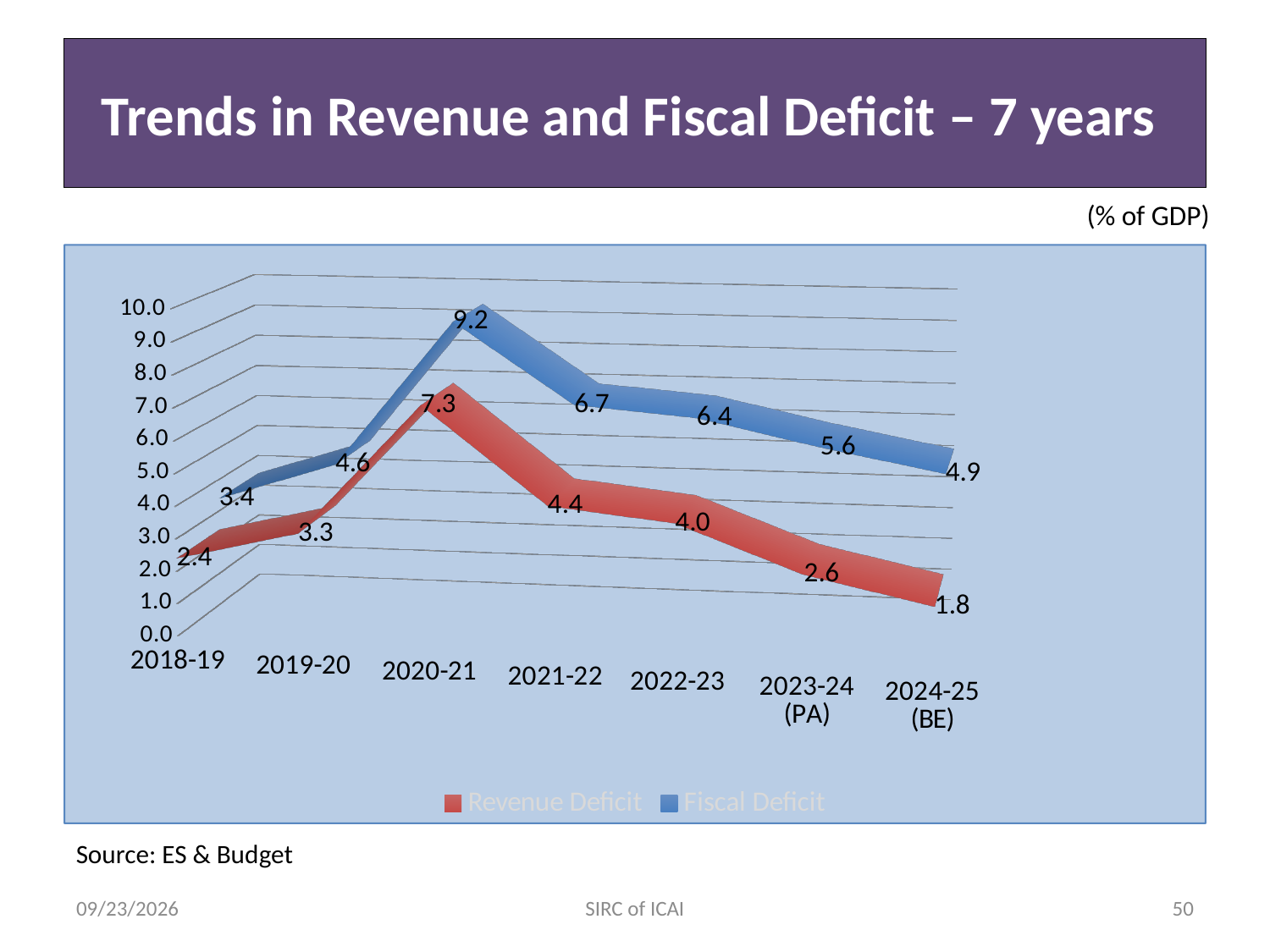
What is the Revenue Deficit value for 2018-19? 2.4 What is the difference between the Fiscal Deficit and the Revenue Deficit in 2022-23? 2.4 In which year is the Revenue Deficit lowest? 2024-25 (BE) What is the Fiscal Deficit value for 2020-21? 9.2 Does the Fiscal Deficit rise or fall from 2020-21 to 2024-25 (BE)? Fall What is the Revenue Deficit value for 2024-25 (BE)? 1.8 How many years are plotted on the x axis? 7 Which is larger in 2023-24 (PA): the Revenue Deficit or the Fiscal Deficit? Fiscal Deficit How many series does the legend list? 2 In which year is the Fiscal Deficit highest? 2020-21 What unit is indicated above the chart? % of GDP What kind of chart is shown on the slide? Line chart